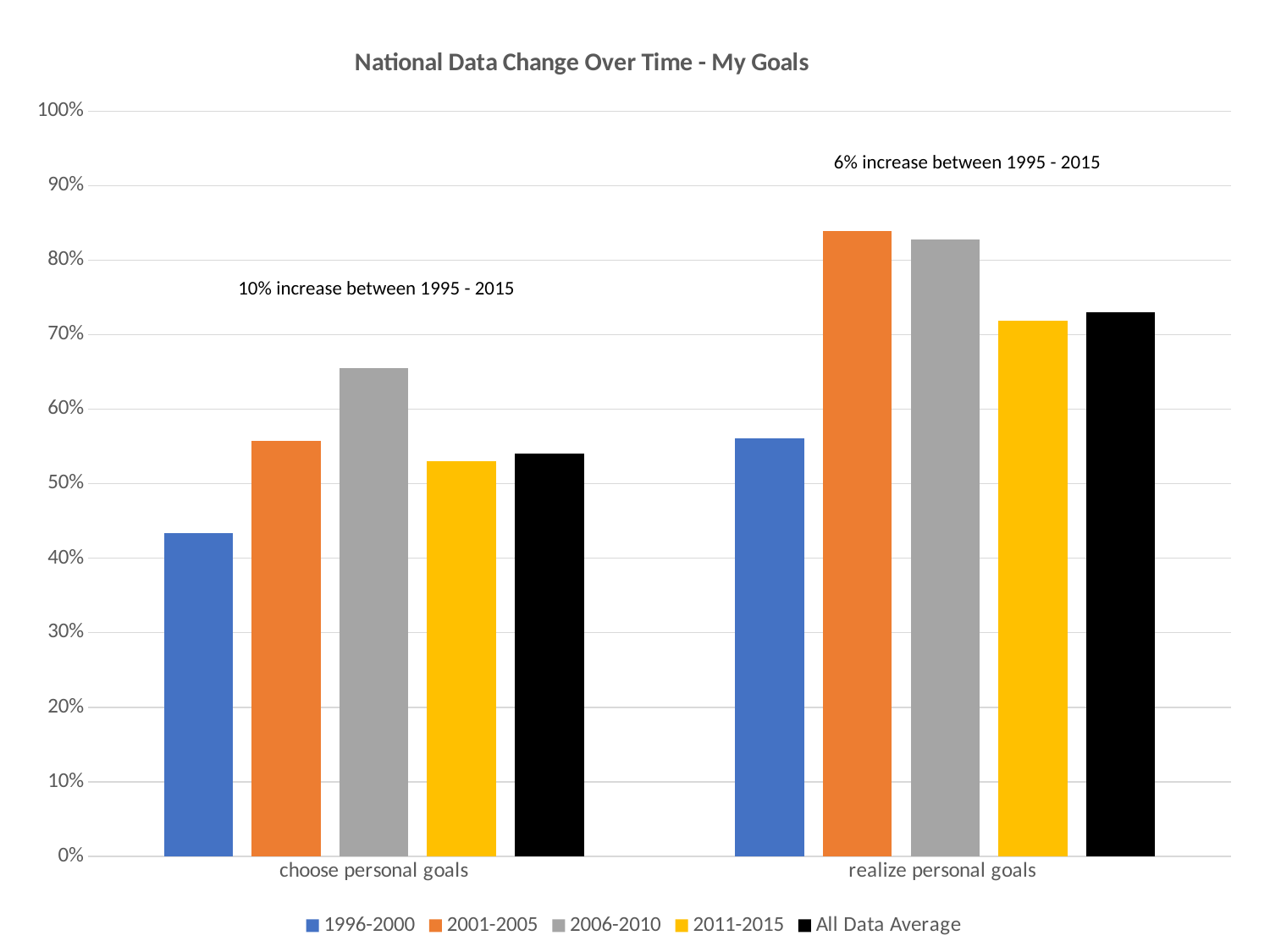
What is the title of the chart? National Data Change Over Time - My Goals Is the value for 2001-2005 under 'realize personal goals' greater or less than 80%? greater For 'choose personal goals', which series has the highest bar? 2006-2010 How many series does the legend list? 5 How many categories are shown on the x axis? 2 Is the value for 1996-2000 under 'choose personal goals' greater or less than 50%? less What kind of chart is shown on the slide? bar chart Which is larger: the 2006-2010 bar for 'choose personal goals' or the 2006-2010 bar for 'realize personal goals'? realize personal goals According to the annotation on the chart, what was the increase between 1995 - 2015 for 'realize personal goals'? 6% increase For 'realize personal goals', which series has the lowest bar? 1996-2000 Is the value for 2011-2015 under 'realize personal goals' greater or less than 70%? greater For 'choose personal goals', which series has the lowest bar? 1996-2000